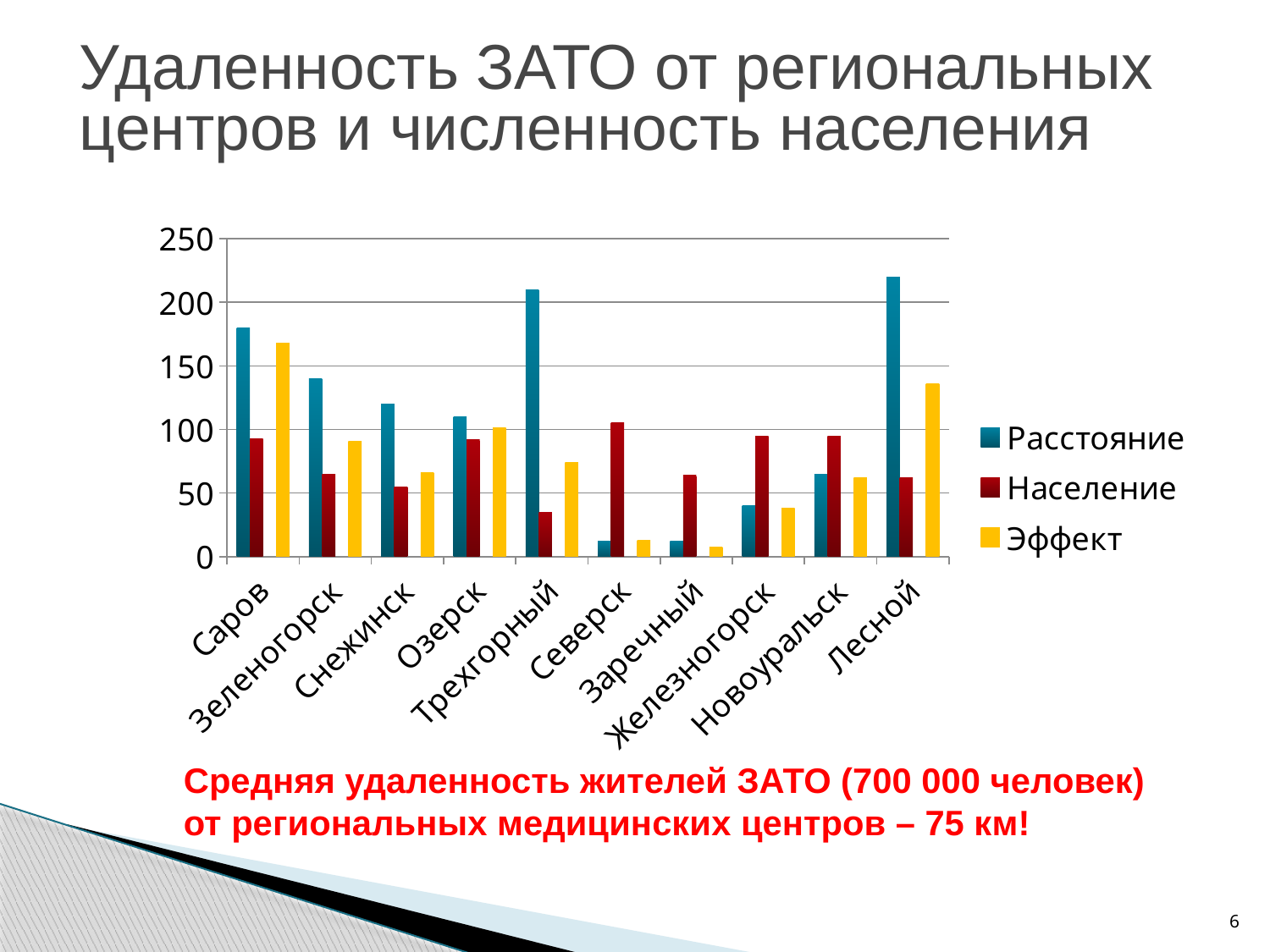
Is the Расстояние value for Саров greater or less than 150? greater Is the Расстояние value for Трехгорный greater or less than 200? greater Is the Расстояние value for Северск greater or less than 50? less How many cities (categories) are shown on the x axis? 10 How many series does the legend list? 3 For Северск, which is larger: Расстояние or Население? Население For Саров, which is larger: Расстояние or Население? Расстояние What are the three series named in the legend? Расстояние, Население, Эффект Which city has the lowest value for Население? Трехгорный Which city has the highest value for Эффект? Саров What kind of chart is shown on the slide? bar chart